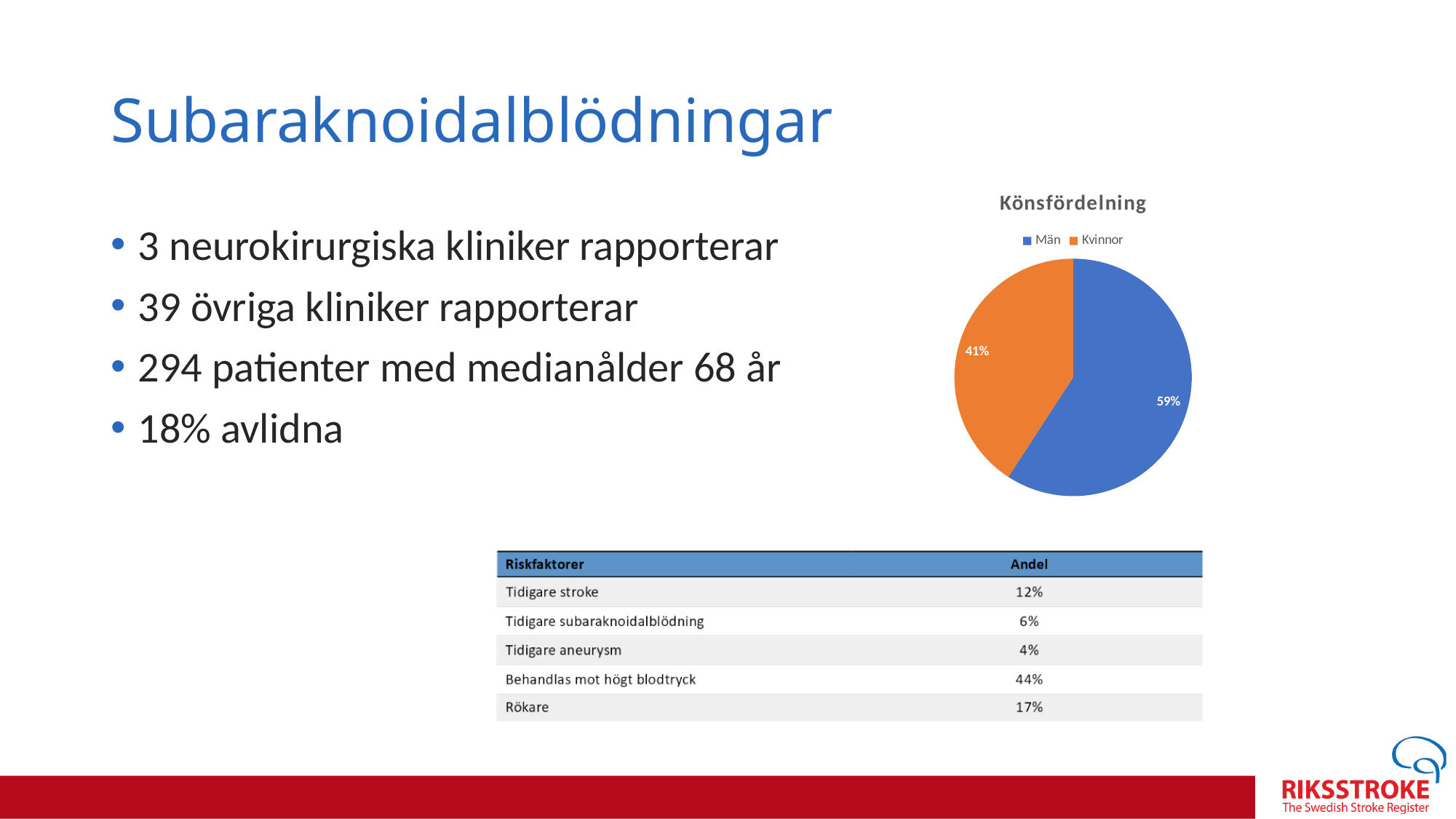
What kind of chart is the Könsfördelning chart? pie chart What share of the pie chart is Kvinnor? 41% What share of the pie chart is Män? 59% How many slices does the pie chart have? 2 Which slice of the pie chart is the smallest? Kvinnor What is the difference in percentage points between the Män and Kvinnor slices? 18 Is the Män share of the pie chart greater or less than 50%? greater Which slice of the pie chart is the largest? Män What is the title of the pie chart? Könsfördelning How many entries does the pie chart legend list? 2 Which is larger in the pie chart, Män or Kvinnor? Män Which colour represents Kvinnor in the pie chart? orange